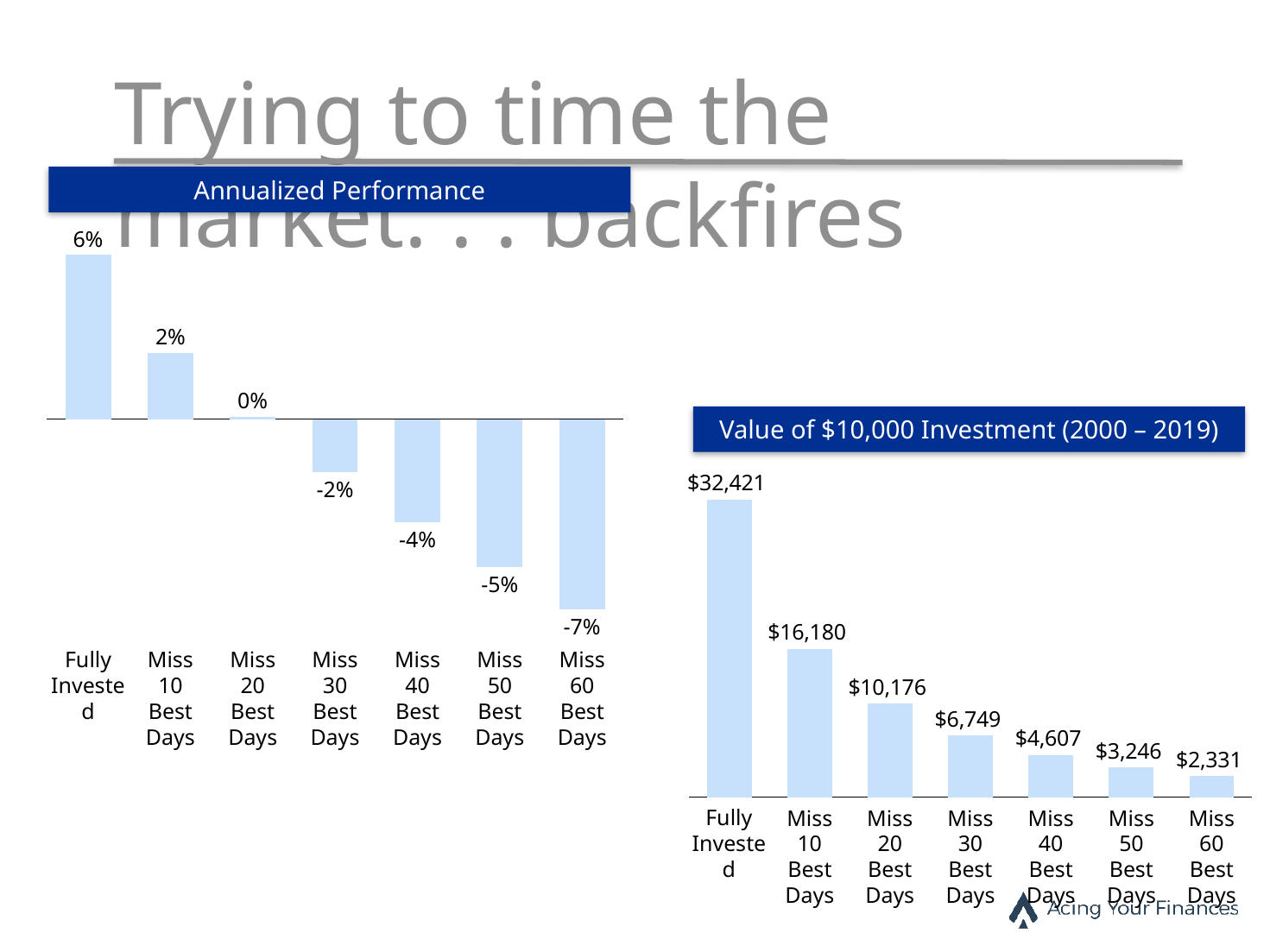
In the Annualized Performance chart, what is the difference between Fully Invested and Miss 10 Best Days? 4% In the Value of $10,000 Investment (2000 – 2019) chart, which category has the highest value? Fully Invested In the Annualized Performance chart, do the values rise or fall from left to right? fall In the Value of $10,000 Investment (2000 – 2019) chart, what is the value for Miss 30 Best Days? $6,749 In the Value of $10,000 Investment (2000 – 2019) chart, what is the difference between Miss 10 Best Days and Miss 20 Best Days? $6,004 In the Value of $10,000 Investment (2000 – 2019) chart, which is larger, Miss 40 Best Days or Miss 50 Best Days? Miss 40 Best Days In the Annualized Performance chart, what is the value for Fully Invested? 6% In the Annualized Performance chart, which category has the lowest value? Miss 60 Best Days In the Annualized Performance chart, what is the value for Miss 40 Best Days? -4% In the Annualized Performance chart, how many categories are shown? 7 In the Value of $10,000 Investment (2000 – 2019) chart, what is the value for Fully Invested? $32,421 What kind of chart is the Value of $10,000 Investment (2000 – 2019) chart? bar chart